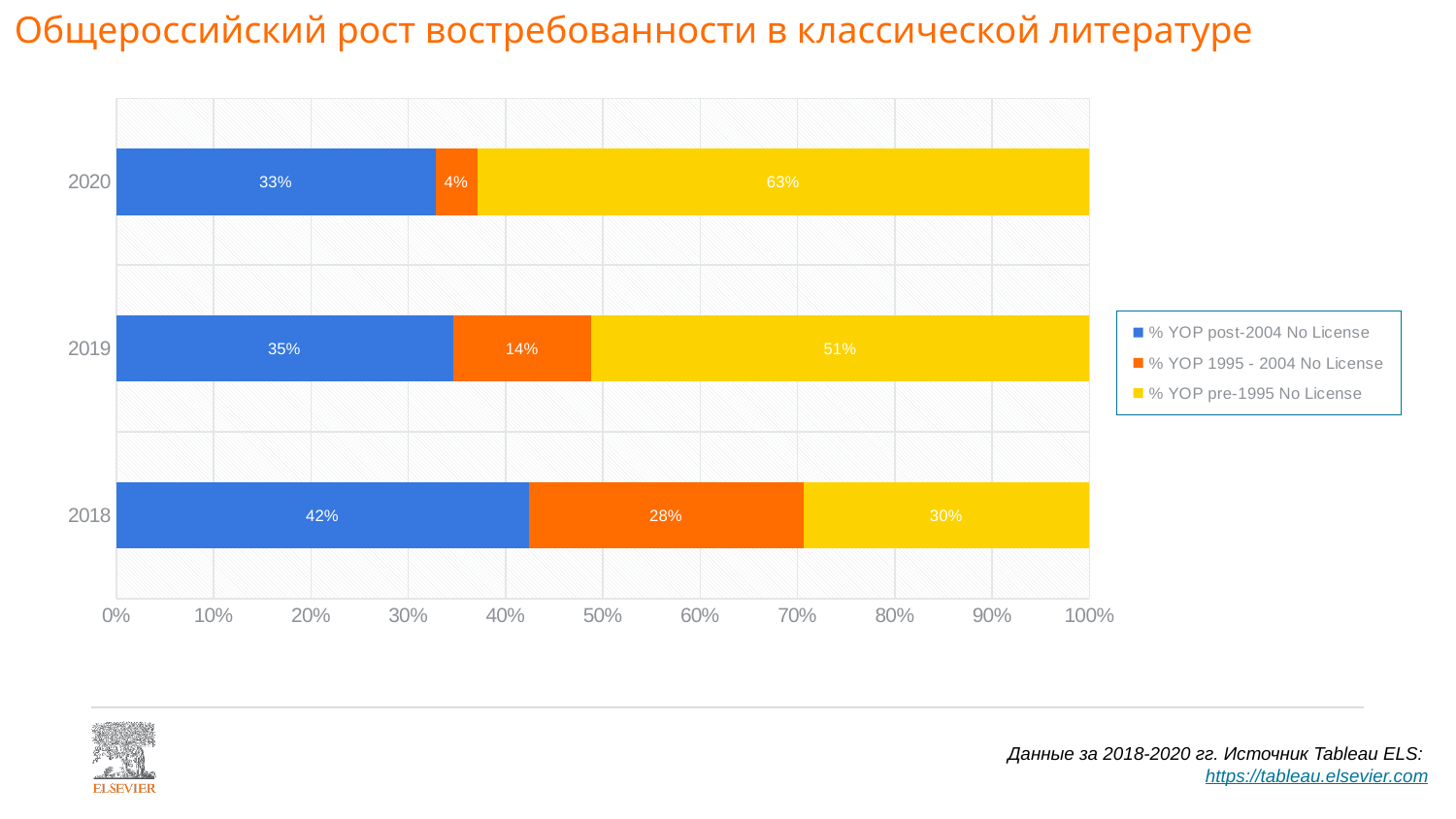
Which year has the highest value for % YOP pre-1995 No License? 2020 Does the value for % YOP 1995 - 2004 No License rise or fall from 2018 to 2020? Fall How many series does the legend list? 3 What is the value for % YOP 1995 - 2004 No License in 2018? 28% What is the total of the stacked bar for 2018? 100% What is the value for % YOP pre-1995 No License in 2020? 63% What is the value for % YOP post-2004 No License in 2019? 35% What is the difference between the % YOP post-2004 No License values for 2018 and 2020? 9% What kind of chart is shown on the slide? Stacked bar chart Which year has the lowest value for % YOP 1995 - 2004 No License? 2020 How many years are shown on the chart? 3 Which is larger in 2019: % YOP post-2004 No License or % YOP pre-1995 No License? % YOP pre-1995 No License